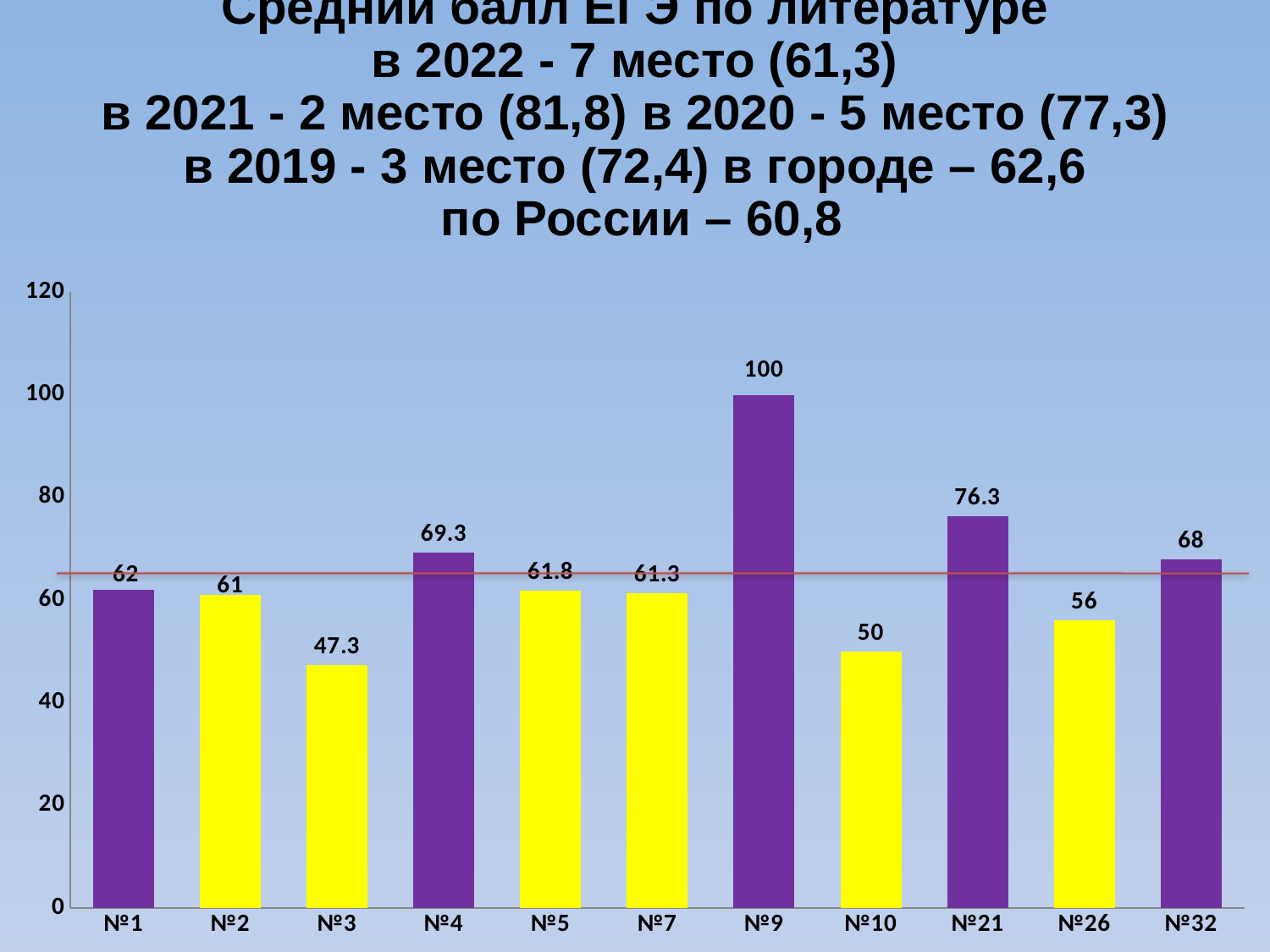
Which category has the lowest value? №3 Is the value for №10 greater or less than 60? less What is the difference between the values for №9 and №21? 23.7 How many categories are shown on the x axis? 11 What kind of chart is shown on the slide? bar chart What is the value for №26? 56 What is the value for №9? 100 What is the value for №21? 76.3 What is the value for №3? 47.3 Which category has the highest value? №9 Which is larger, the value for №4 or the value for №32? №4 What is the difference between the values for №32 and №10? 18